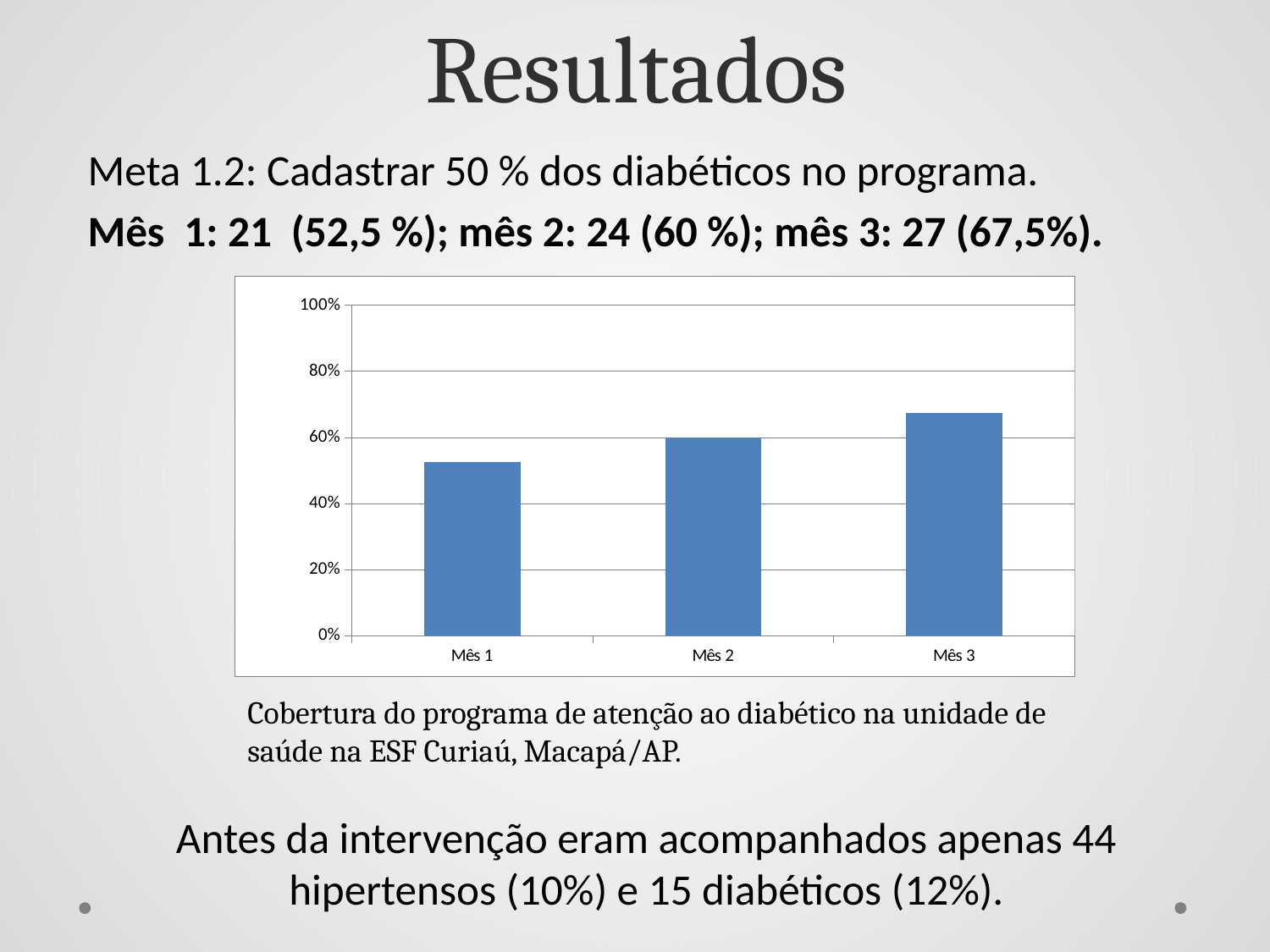
What value does the bar for Mês 2 reach on the y axis? 60% Which month has the lowest bar in the chart? Mês 1 What kind of chart is shown on the slide? bar chart Is the value for Mês 1 greater or less than 60%? less Do the values rise or fall from Mês 1 to Mês 3? rise What is the highest tick value shown on the y axis of the chart? 100% Is the value for Mês 1 greater or less than 40%? greater According to the slide text, what percentage does the bar for Mês 3 represent? 67,5% Which month has the highest bar in the chart? Mês 3 Is the value for Mês 3 greater or less than 80%? less How many bars (categories) does the chart show? 3 Which is larger, the value for Mês 2 or the value for Mês 3? Mês 3